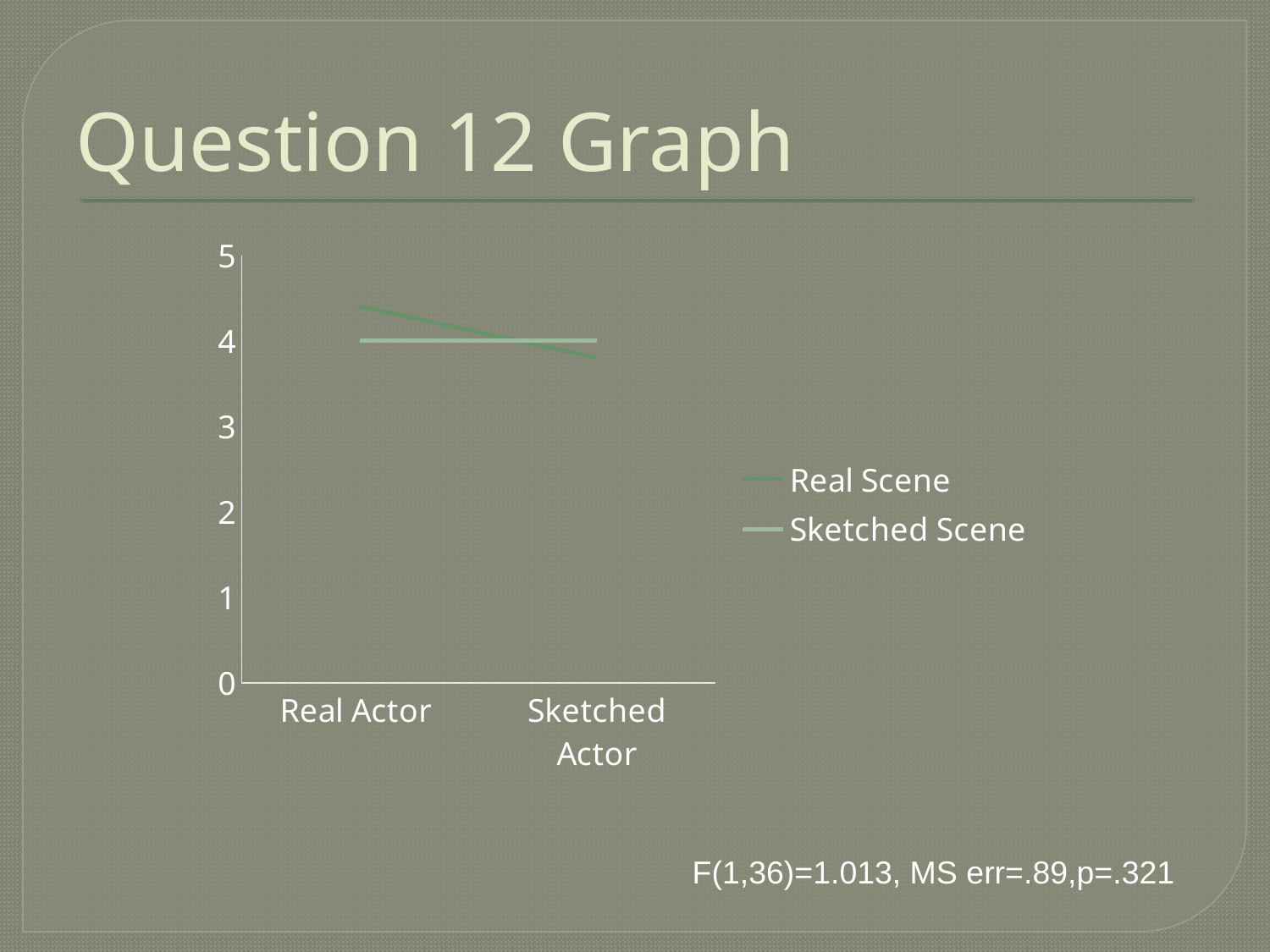
What is the title of the chart? Question 12 Graph At Real Actor, which series has the higher value, Real Scene or Sketched Scene? Real Scene Is the Real Scene value for Real Actor greater or less than 4? greater For the Real Scene series, which category has the lowest value? Sketched Actor How many categories are shown on the x axis? 2 Is the Real Scene value for Real Actor greater or less than 5? less Does the Real Scene line rise or fall from Real Actor to Sketched Actor? fall Is the Sketched Scene value for Sketched Actor greater or less than 3? greater What kind of chart is shown on the slide? line chart For the Real Scene series, which category has the higher value? Real Actor How many series does the legend list? 2 What are the two series named in the legend? Real Scene and Sketched Scene